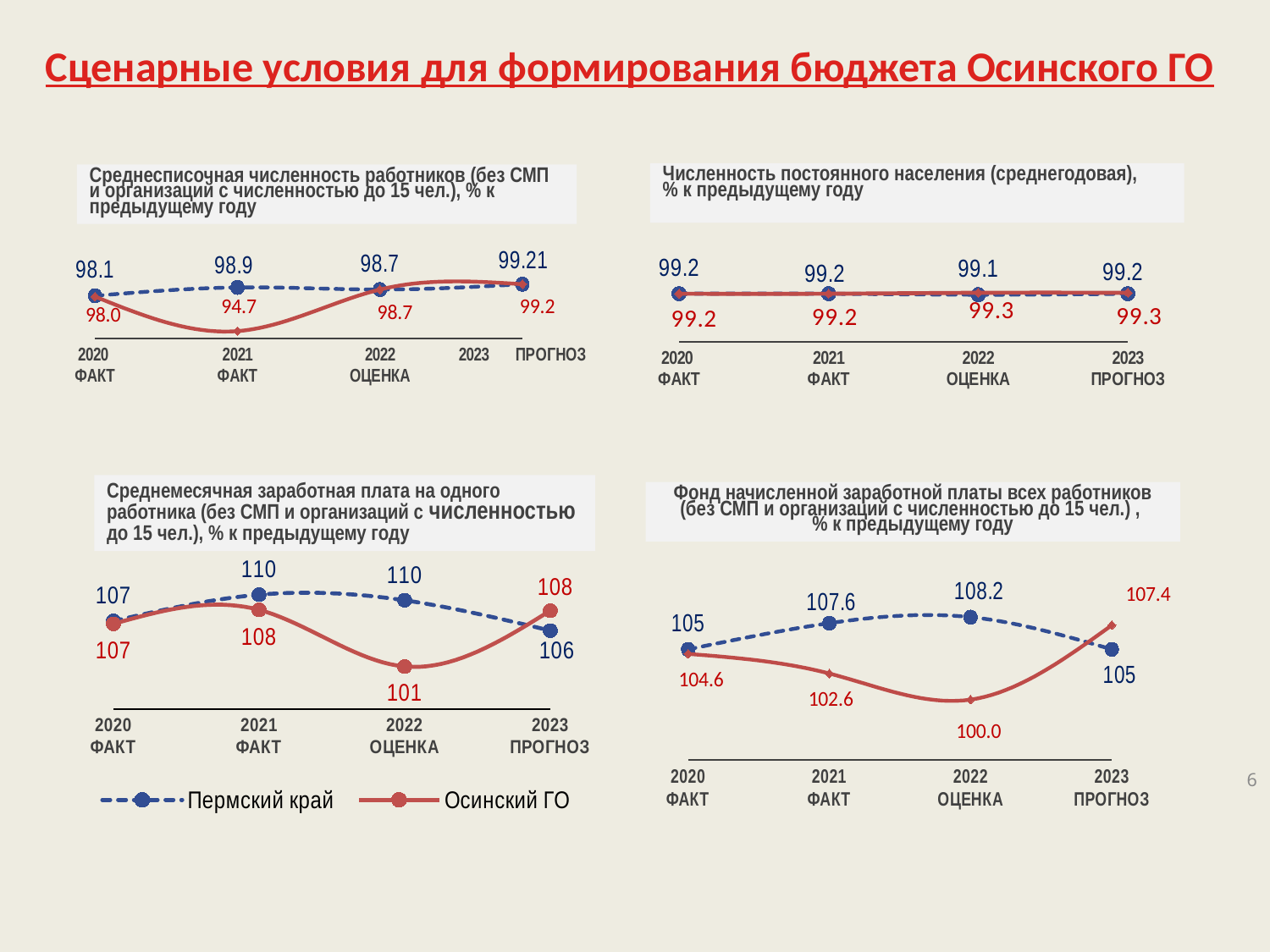
In the chart 'Среднемесячная заработная плата', which series has the higher value in 2023 ПРОГНОЗ, Пермский край or Осинский ГО? Осинский ГО In the chart 'Среднесписочная численность работников', which year has the lowest value for Осинский ГО? 2021 ФАКТ What kind of chart is the chart 'Фонд начисленной заработной платы'? Line chart In the chart 'Среднемесячная заработная плата', what is the difference between Пермский край and Осинский ГО in 2022 ОЦЕНКА? 9 In the chart 'Фонд начисленной заработной платы', what is the value for Осинский ГО in 2022 ОЦЕНКА? 100.0 In the chart 'Среднесписочная численность работников', what is the value for Осинский ГО in 2021 ФАКТ? 94.7 In the chart 'Фонд начисленной заработной платы', which year has the highest value for Пермский край? 2022 ОЦЕНКА In the chart 'Численность постоянного населения', what is the value for Осинский ГО in 2022 ОЦЕНКА? 99.3 In the chart 'Среднесписочная численность работников', what is the value for Пермский край in 2023 ПРОГНОЗ? 99.21 How many series does the legend on the slide list? 2 In the chart 'Среднемесячная заработная плата', what is the value for Осинский ГО in 2022 ОЦЕНКА? 101 In the chart 'Численность постоянного населения', what is the value for Пермский край in 2022 ОЦЕНКА? 99.1